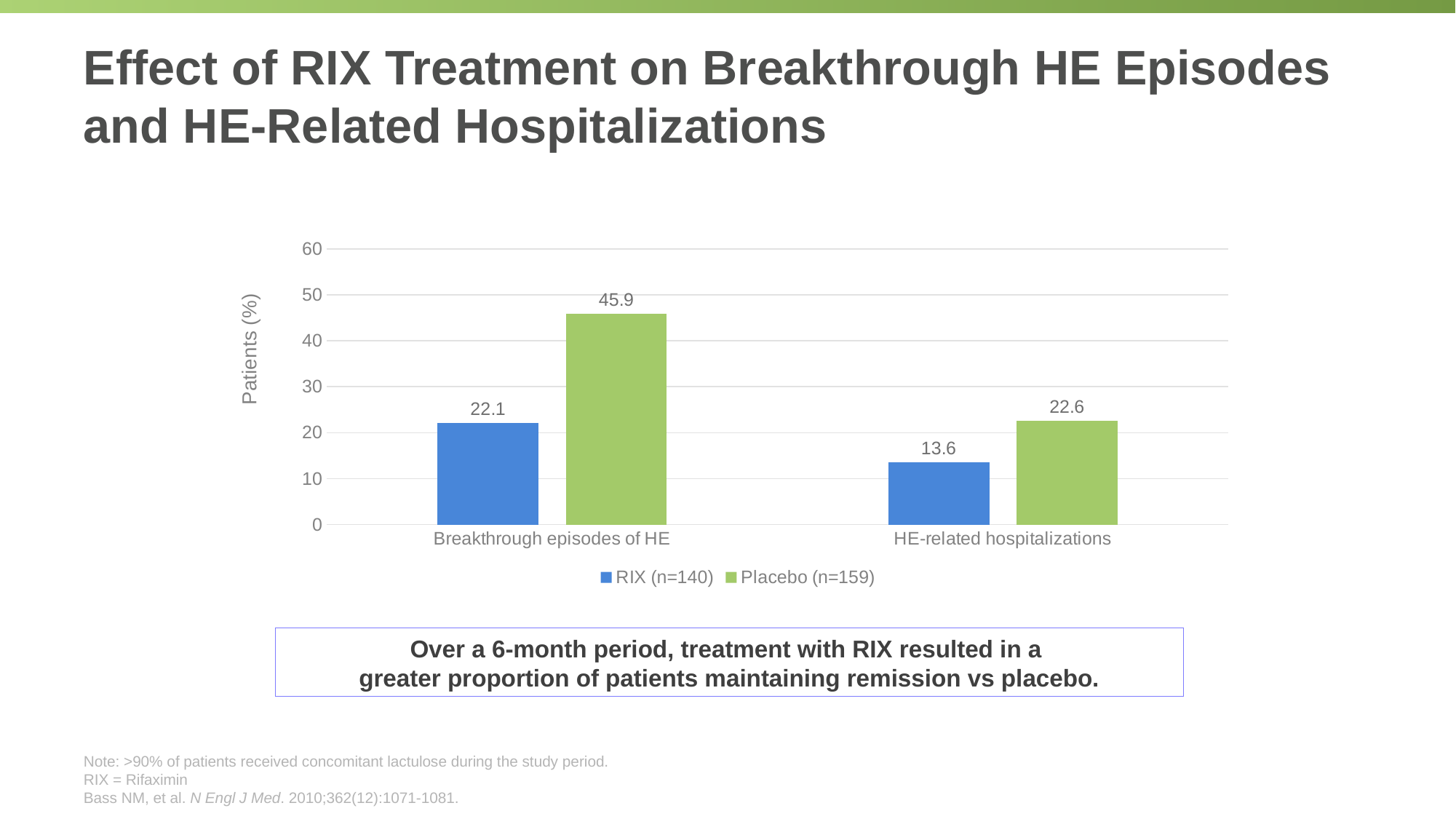
What percentage of patients in the RIX (n=140) group had HE-related hospitalizations? 13.6 What percentage of patients in the Placebo (n=159) group had HE-related hospitalizations? 22.6 What is the difference between the Placebo and RIX values for HE-related hospitalizations? 9.0 What is the label of the y axis? Patients (%) What is the difference between the Placebo and RIX values for breakthrough episodes of HE? 23.8 How many series does the legend list? 2 For HE-related hospitalizations, which group has the larger value, RIX or Placebo? Placebo Which bar shows the highest value on the chart? Placebo (n=159), Breakthrough episodes of HE What percentage of patients in the RIX (n=140) group had breakthrough episodes of HE? 22.1 What kind of chart is shown on the slide? Bar chart Which bar shows the lowest value on the chart? RIX (n=140), HE-related hospitalizations What percentage of patients in the Placebo (n=159) group had breakthrough episodes of HE? 45.9